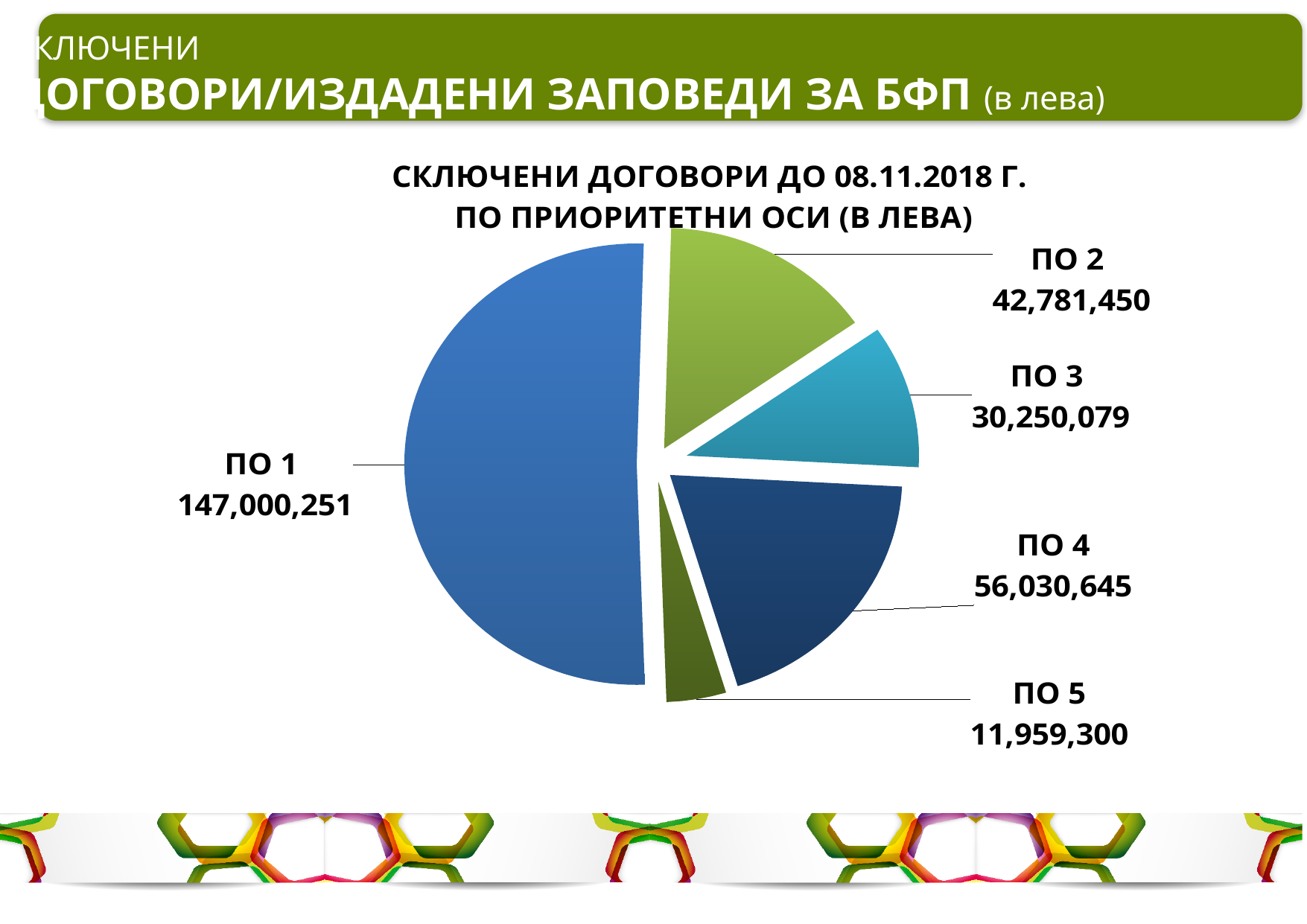
Which priority axis has the largest slice of the pie? ПО 1 What is the value for ПО 3? 30,250,079 What is the difference between the values for ПО 4 and ПО 2? 13,249,195 Which is larger, the value for ПО 2 or the value for ПО 4? ПО 4 Which priority axis has the smallest slice of the pie? ПО 5 What type of chart is shown on the slide? Pie chart What is the title of the pie chart? СКЛЮЧЕНИ ДОГОВОРИ ДО 08.11.2018 Г. ПО ПРИОРИТЕТНИ ОСИ (В ЛЕВА) How many slices does the pie chart have? 5 What is the value for ПО 5? 11,959,300 What is the total of all slices in the pie chart? 288,021,725 What is the difference between the values for ПО 3 and ПО 5? 18,290,779 What is the value for ПО 1? 147,000,251